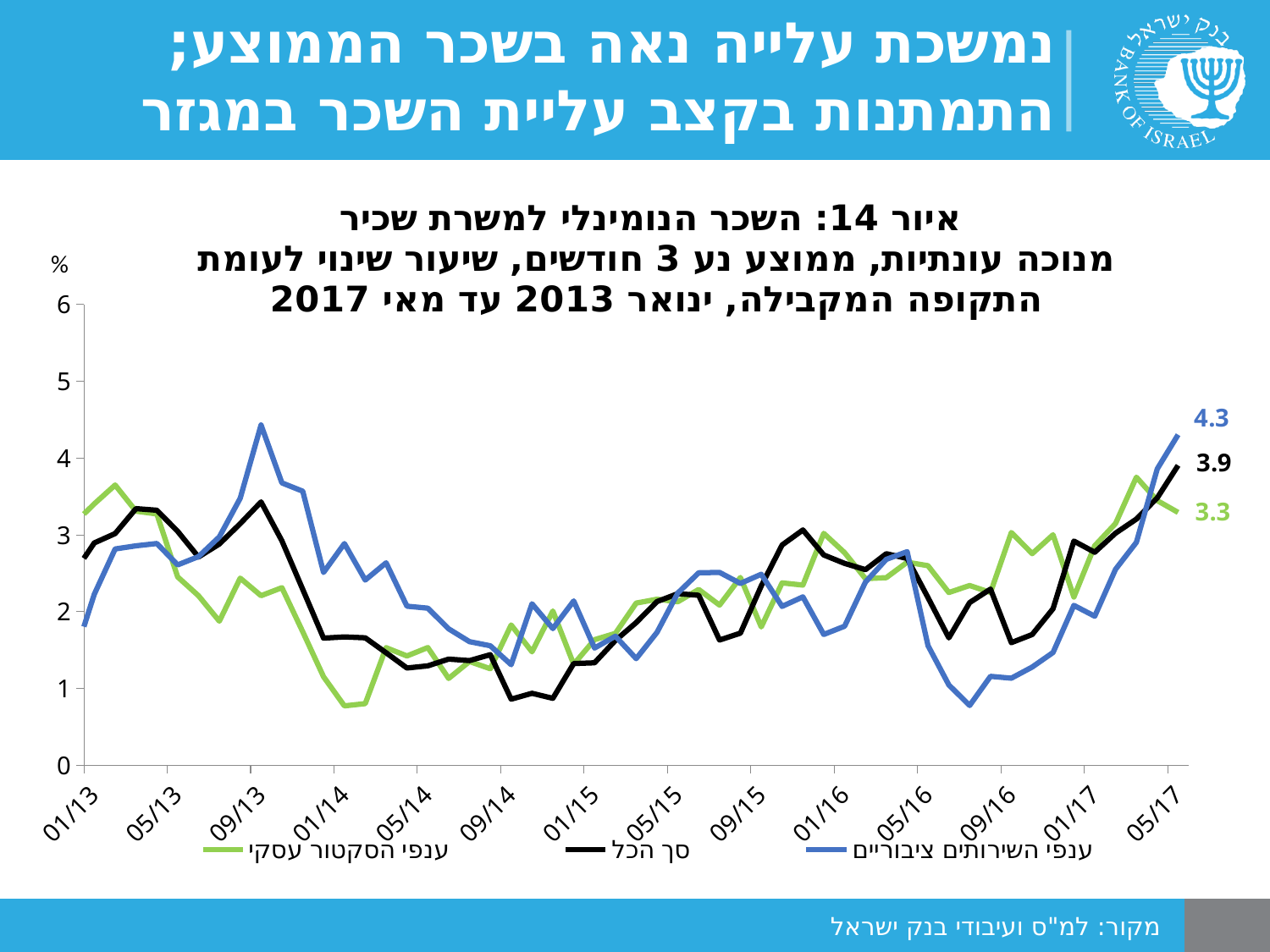
What is the final labelled value for the total series (סך הכל) in 05/17? 3.9 What unit is shown on the y axis? % What is the final labelled value for the public services series (ענפי השירותים ציבוריים) in 05/17? 4.3 How many series does the legend list? 3 What is the difference between the final labelled values of the public services series (4.3) and the business sector series (3.3)? 1.0 Which series has the highest labelled value at the end of the period (05/17)? ענפי השירותים ציבוריים What is the difference between the final labelled values of the public services series (4.3) and the total series (3.9)? 0.4 Which series has the lowest labelled value at the end of the period (05/17)? ענפי הסקטור עסקי What is the final labelled value for the business sector series (ענפי הסקטור עסקי) in 05/17? 3.3 What kind of chart is shown on the slide? line chart Which series is drawn in black? סך הכל Is the value of the public services series (blue line) in 09/16 greater or less than 2? less